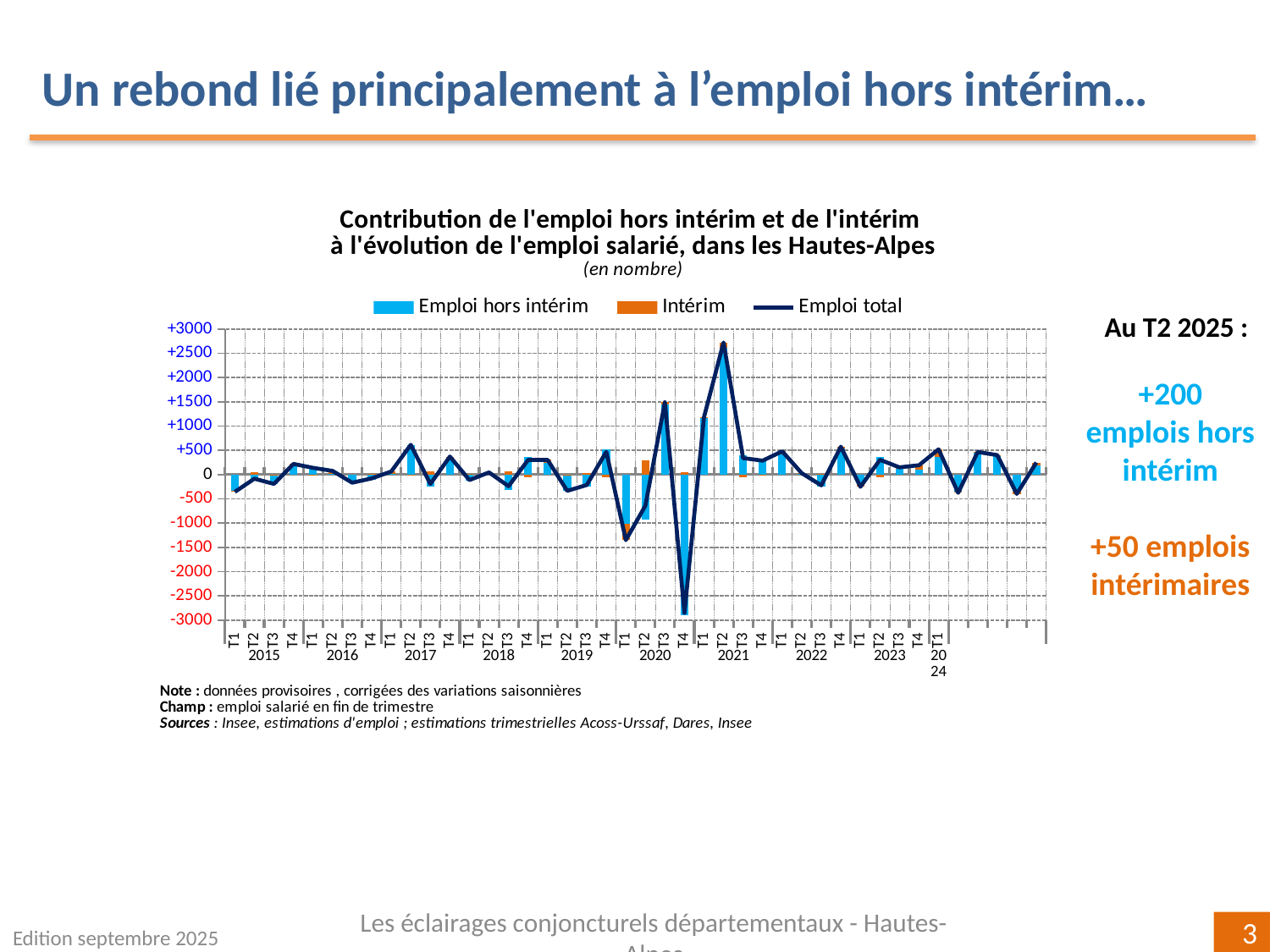
Is the Emploi total value for T3 2020 greater or less than +1000? greater Between T4 2020 and T2 2021, does the Emploi total line rise or fall? rise Is the Emploi total value for T1 2020 greater or less than -1000? less How many series does the chart legend list? 3 Is the Emploi total value for T4 2020 greater or less than -2000? less Which is larger, the Emploi total value for T3 2020 or for T2 2021? T2 2021 In which quarter does the Emploi total line reach its lowest value? T4 2020 Which series is drawn as a line rather than bars? Emploi total What is the highest value shown on the vertical axis of the chart? +3000 What kind of chart is shown on the slide? A combined bar and line chart In which quarter does the Emploi total line reach its highest value? T2 2021